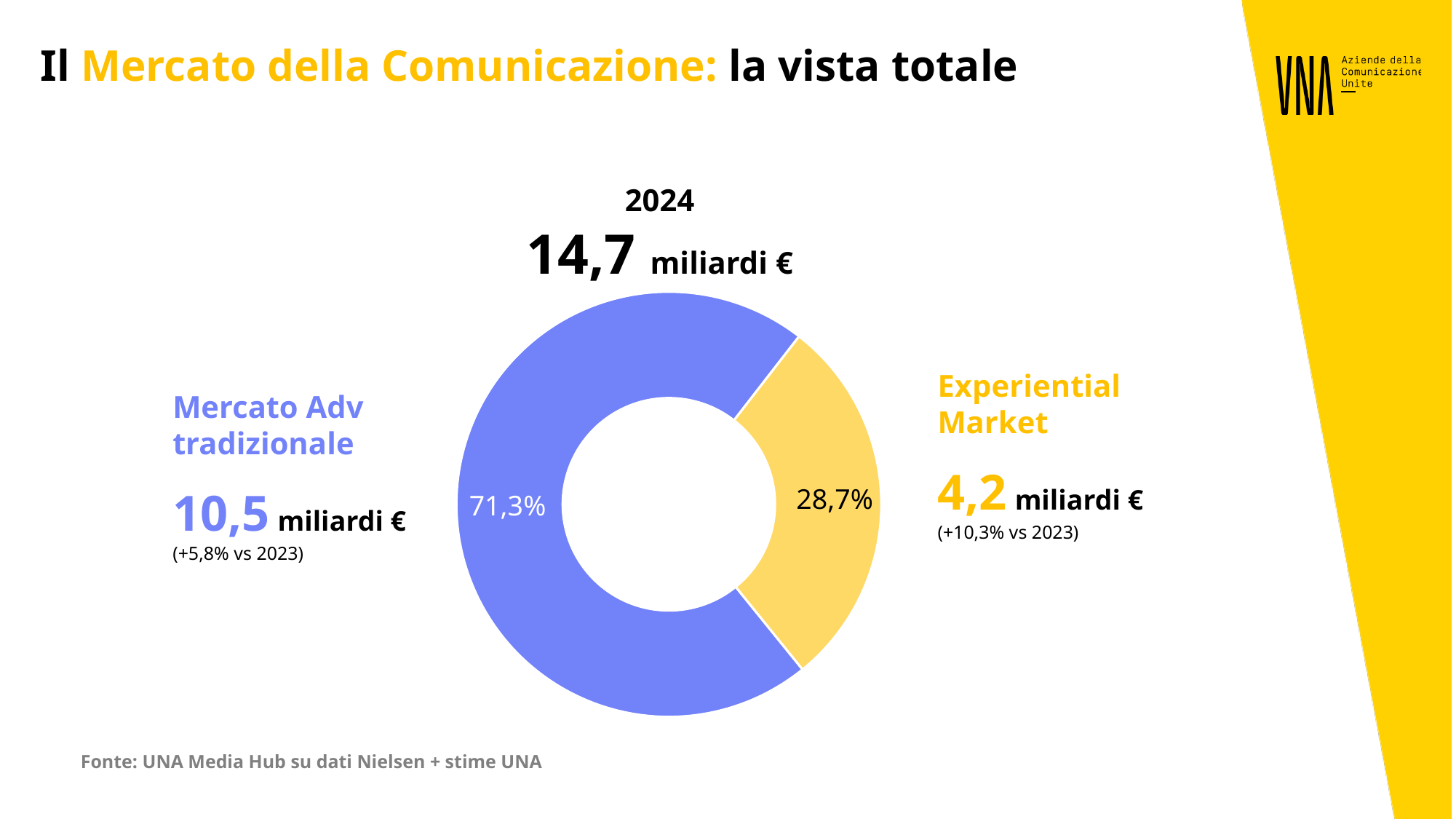
What is the value shown for Mercato Adv tradizionale? 10,5 miliardi € What is the value shown for Experiential Market? 4,2 miliardi € What year does the donut chart refer to? 2024 Which segment of the donut chart is the largest? Mercato Adv tradizionale What share of the donut chart does Experiential Market represent? 28,7% Which segment of the donut chart is the smallest? Experiential Market What share of the donut chart does Mercato Adv tradizionale represent? 71,3% Which is larger, the share for Mercato Adv tradizionale or the share for Experiential Market? Mercato Adv tradizionale What is the total market value shown above the donut chart for 2024? 14,7 miliardi € How many segments does the donut chart have? 2 What kind of chart is shown on the slide? Donut (pie) chart What is the difference in percentage points between the Mercato Adv tradizionale share and the Experiential Market share? 42,6 percentage points